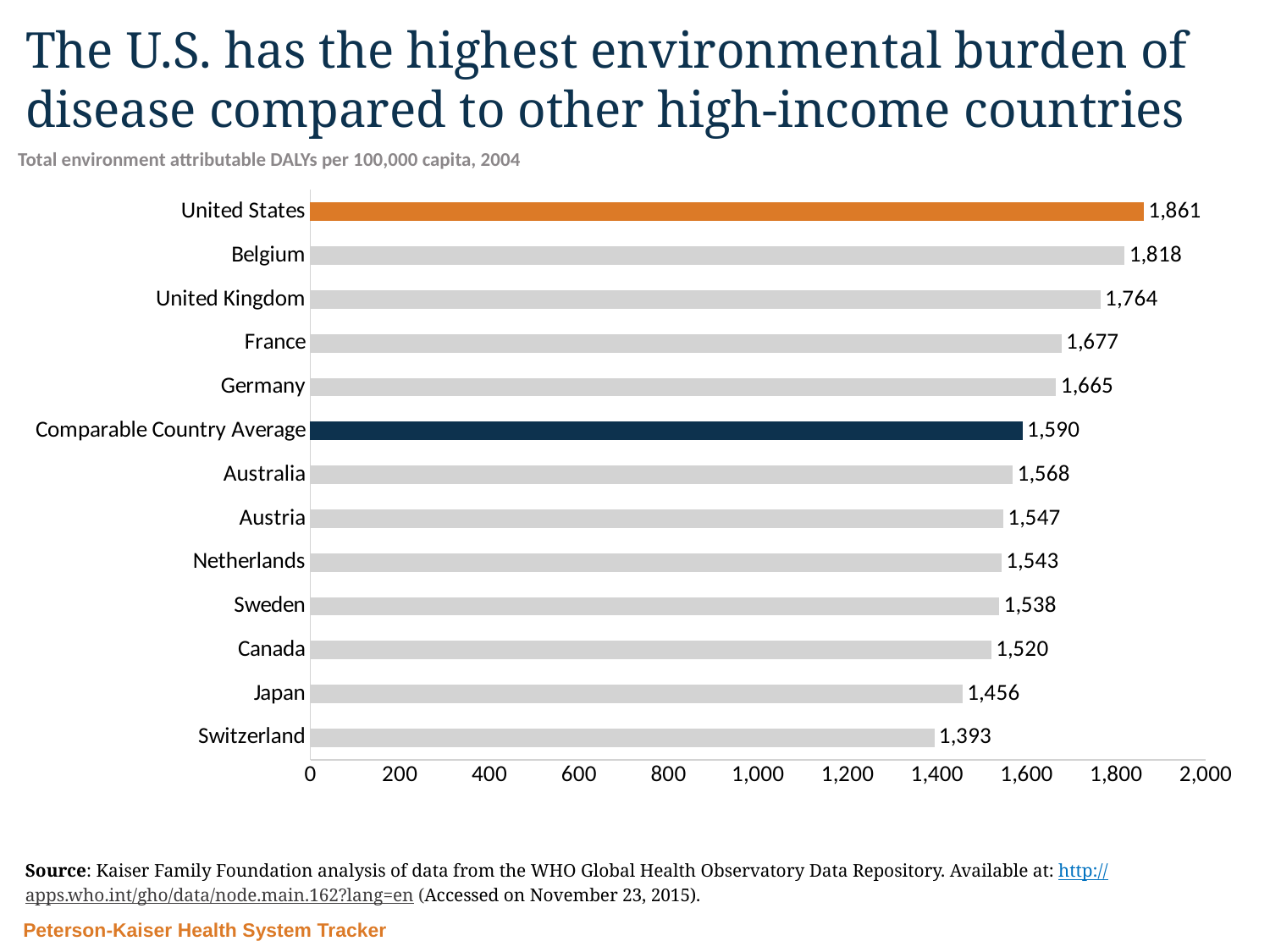
What is the difference between the values for Belgium and Switzerland? 425 Which category has the lowest value? Switzerland Which category has the highest value? United States What is the difference between the values for the United States and the Comparable Country Average? 271 What is the subtitle describing the measure plotted in the chart? Total environment attributable DALYs per 100,000 capita, 2004 Is the value for Germany greater or less than 1,600? greater What is the value for the United States? 1,861 What kind of chart is shown on the slide? Bar chart How many bars are shown in the chart? 13 What is the value for Japan? 1,456 Which has a larger value, France or Canada? France What is the value for the Comparable Country Average? 1,590